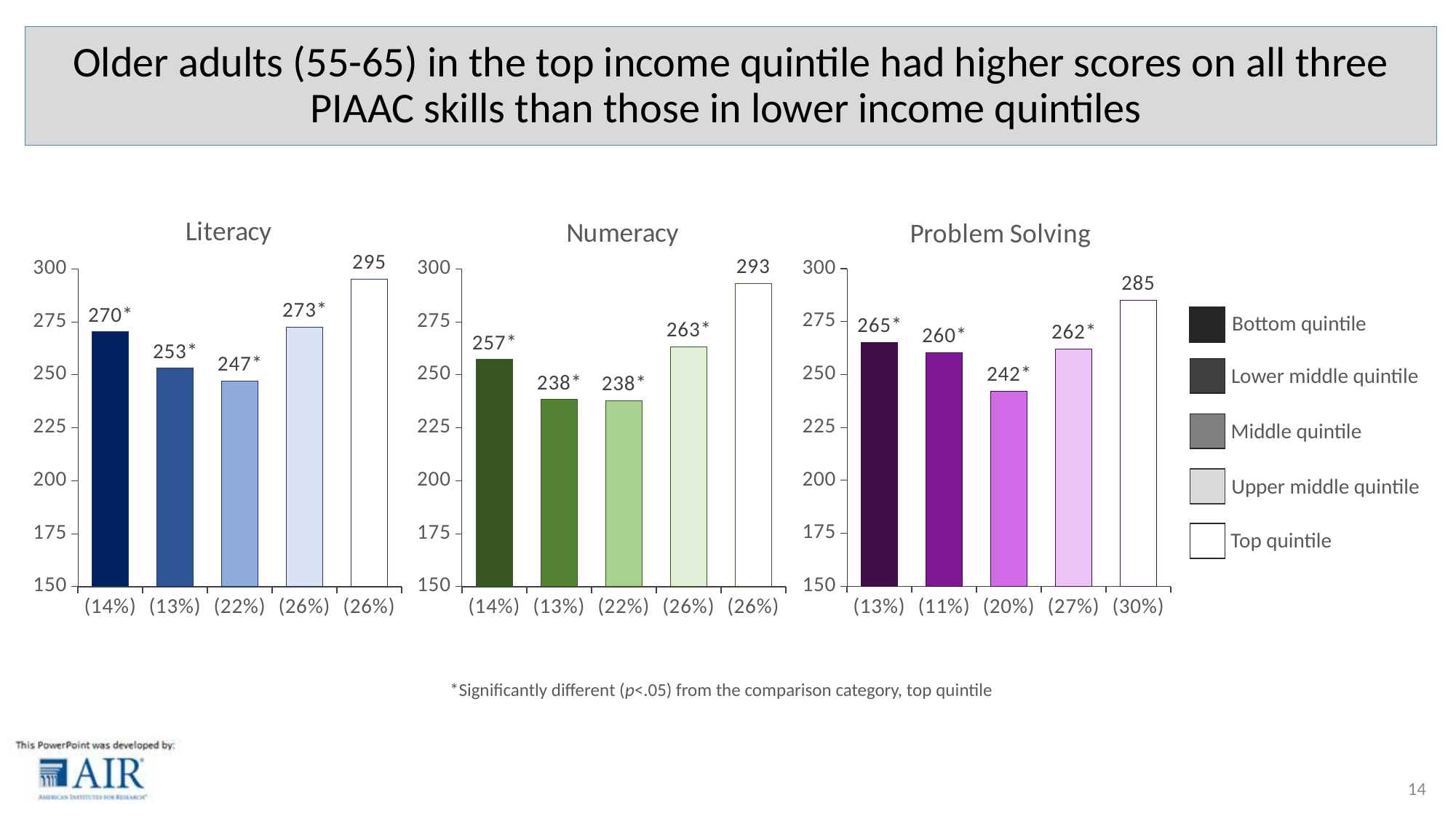
In the Numeracy chart, what is the score for the bottom quintile? 257* In the Numeracy chart, what is the difference between the top quintile score and the bottom quintile score? 36 How many bars are plotted in the Problem Solving chart? 5 In the Literacy chart, is the score for the bottom quintile or the upper middle quintile larger? Upper middle quintile In the Literacy chart, what is the score for the top quintile? 295 In the Numeracy chart, is the value for the lower middle quintile greater or less than 250? less In the Problem Solving chart, which quintile has the highest score? Top quintile In the Literacy chart, which quintile has the lowest score? Middle quintile In the Problem Solving chart, what is the score for the middle quintile? 242* How many quintile categories does the legend list? 5 What is the title of the chart on the right? Problem Solving What kind of chart is the Literacy chart? Bar chart